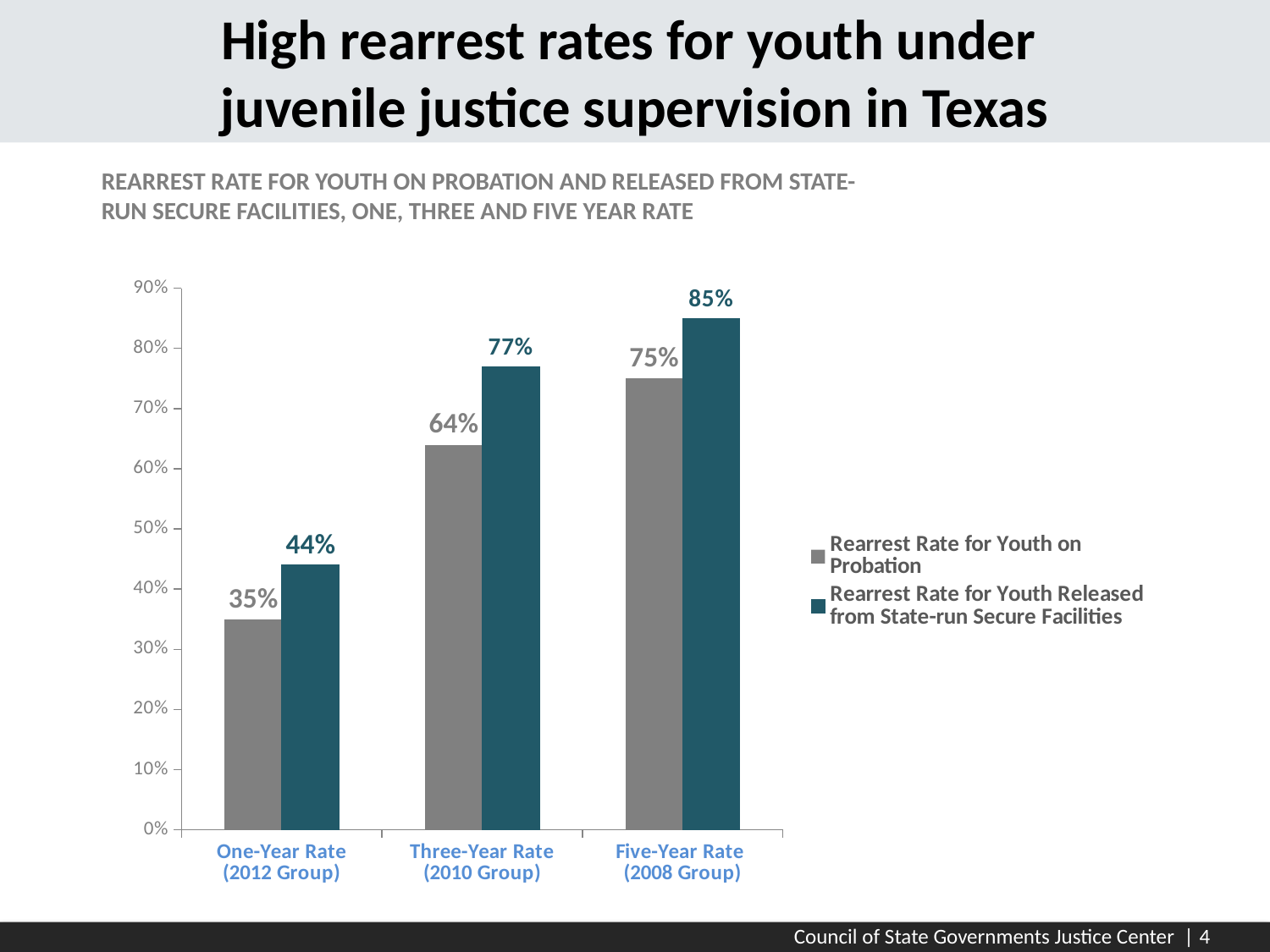
What kind of chart is shown on the slide? Bar chart How many categories are shown on the x axis? 3 What is the rearrest rate for youth released from state-run secure facilities at the Five-Year Rate (2008 Group)? 85% At the Five-Year Rate (2008 Group), which is larger: the rearrest rate for youth on probation or for youth released from state-run secure facilities? Rearrest Rate for Youth Released from State-run Secure Facilities Which category has the highest rearrest rate for youth released from state-run secure facilities? Five-Year Rate (2008 Group) What is the difference between the rearrest rate for youth released from state-run secure facilities and youth on probation at the Three-Year Rate (2010 Group)? 13% Do the rearrest rates for youth on probation rise or fall from the One-Year Rate to the Five-Year Rate? Rise What is the rearrest rate for youth on probation at the One-Year Rate (2012 Group)? 35% What is the rearrest rate for youth on probation at the Three-Year Rate (2010 Group)? 64% What colour are the bars for the rearrest rate for youth on probation? Gray How many series does the legend list? 2 Which category has the lowest rearrest rate for youth on probation? One-Year Rate (2012 Group)